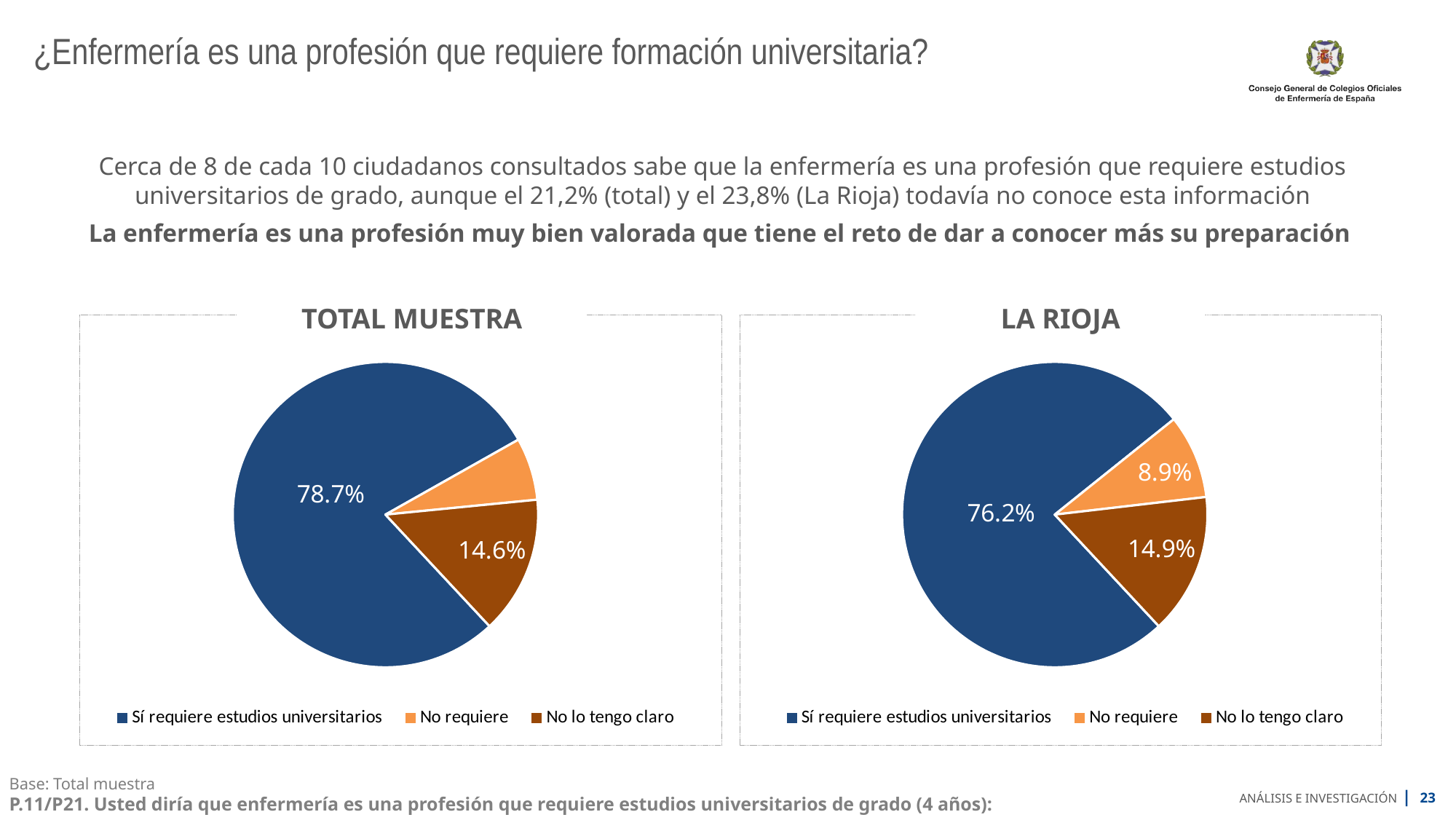
In the LA RIOJA pie chart, what is the difference between the "No lo tengo claro" share and the "No requiere" share? 6.0% In the LA RIOJA pie chart, what share of respondents answered "Sí requiere estudios universitarios"? 76.2% What type of chart is used for LA RIOJA? Pie chart In the LA RIOJA pie chart, which category has the smallest slice? No requiere In the TOTAL MUESTRA pie chart, which category has the largest slice? Sí requiere estudios universitarios In the LA RIOJA pie chart, what share of respondents answered "No lo tengo claro"? 14.9% In the LA RIOJA pie chart, what share of respondents answered "No requiere"? 8.9% In the TOTAL MUESTRA pie chart, what share of respondents answered "Sí requiere estudios universitarios"? 78.7% In the TOTAL MUESTRA chart, what colour is the "No requiere" slice? Light orange How many categories does the legend of the TOTAL MUESTRA chart list? 3 Which chart shows a larger share for "Sí requiere estudios universitarios", TOTAL MUESTRA or LA RIOJA? TOTAL MUESTRA In the TOTAL MUESTRA pie chart, what share of respondents answered "No lo tengo claro"? 14.6%